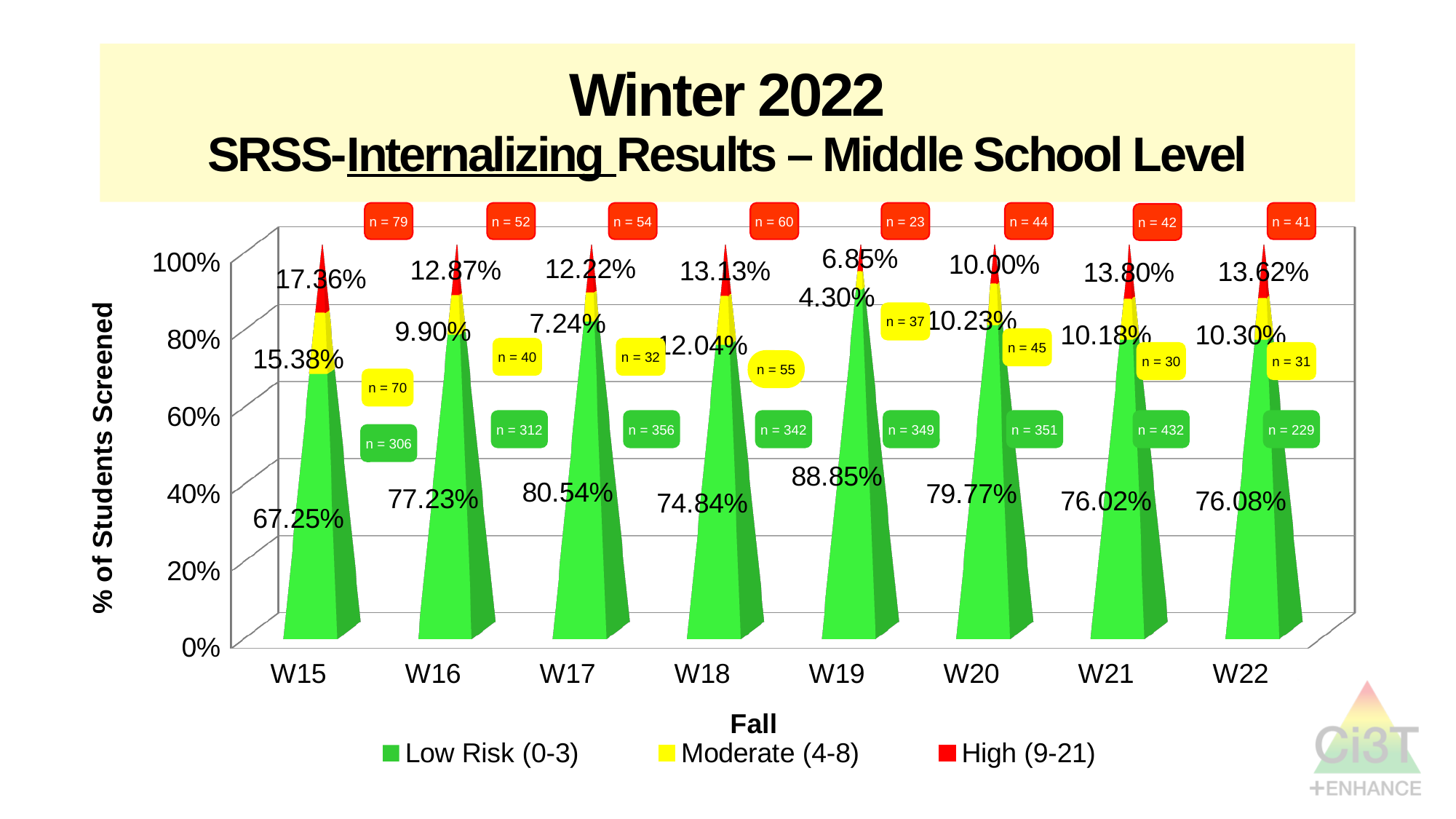
What is the Low Risk (0-3) percentage for W19? 88.85% How many schools are shown on the x axis? 8 What is the n value shown for the Low Risk group at W21? n = 432 Which is larger, the Moderate (4-8) percentage for W15 or for W16? W15 What is the Moderate (4-8) percentage for W18? 12.04% Which school has the lowest High (9-21) percentage? W19 Which school has the highest Low Risk (0-3) percentage? W19 How many series does the legend list? 3 What kind of chart is shown on the slide? Stacked bar chart What is the High (9-21) percentage for W15? 17.36% What is the difference between the Low Risk percentages of W19 and W15? 21.60% Which school has the lowest Low Risk (0-3) percentage? W15